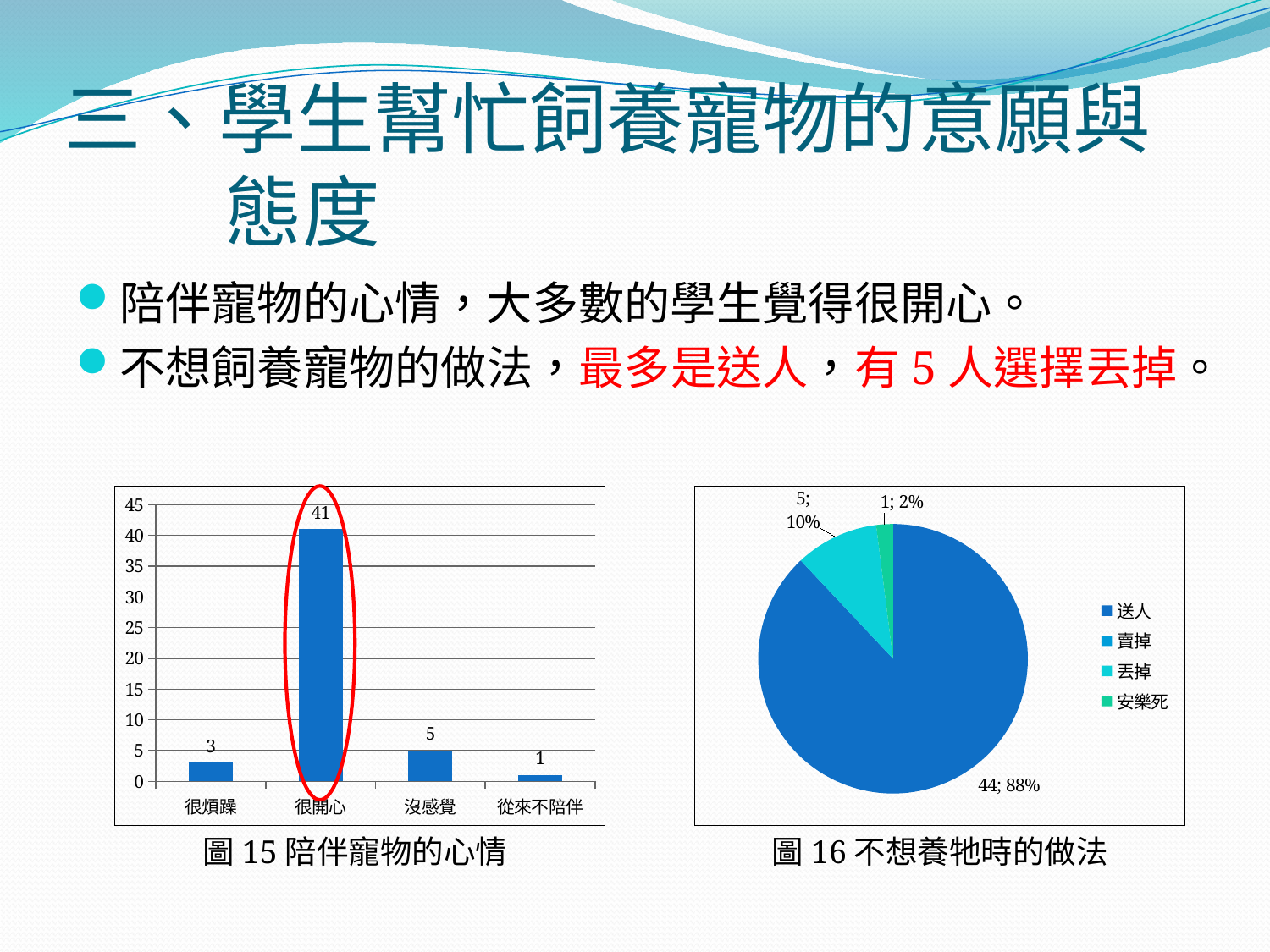
In the chart titled 圖 15 陪伴寵物的心情, what is the value for 很開心? 41 In the chart titled 圖 15 陪伴寵物的心情, which category has the lowest value? 從來不陪伴 What kind of chart is 圖 16 不想養牠時的做法? pie chart In the chart titled 圖 15 陪伴寵物的心情, what is the difference between the values for 很開心 and 沒感覺? 36 In the chart titled 圖 15 陪伴寵物的心情, which is larger, the value for 很煩躁 or the value for 沒感覺? 沒感覺 In the chart titled 圖 15 陪伴寵物的心情, which category has the highest value? 很開心 What kind of chart is 圖 15 陪伴寵物的心情? bar chart In the chart titled 圖 15 陪伴寵物的心情, how many categories are shown on the x axis? 4 In the chart titled 圖 15 陪伴寵物的心情, what is the value for 沒感覺? 5 In the pie chart titled 圖 16 不想養牠時的做法, what share of the pie does 送人 have? 88% In the pie chart titled 圖 16 不想養牠時的做法, what is the value for 丟掉? 5 In the pie chart titled 圖 16 不想養牠時的做法, how many entries does the legend list? 4